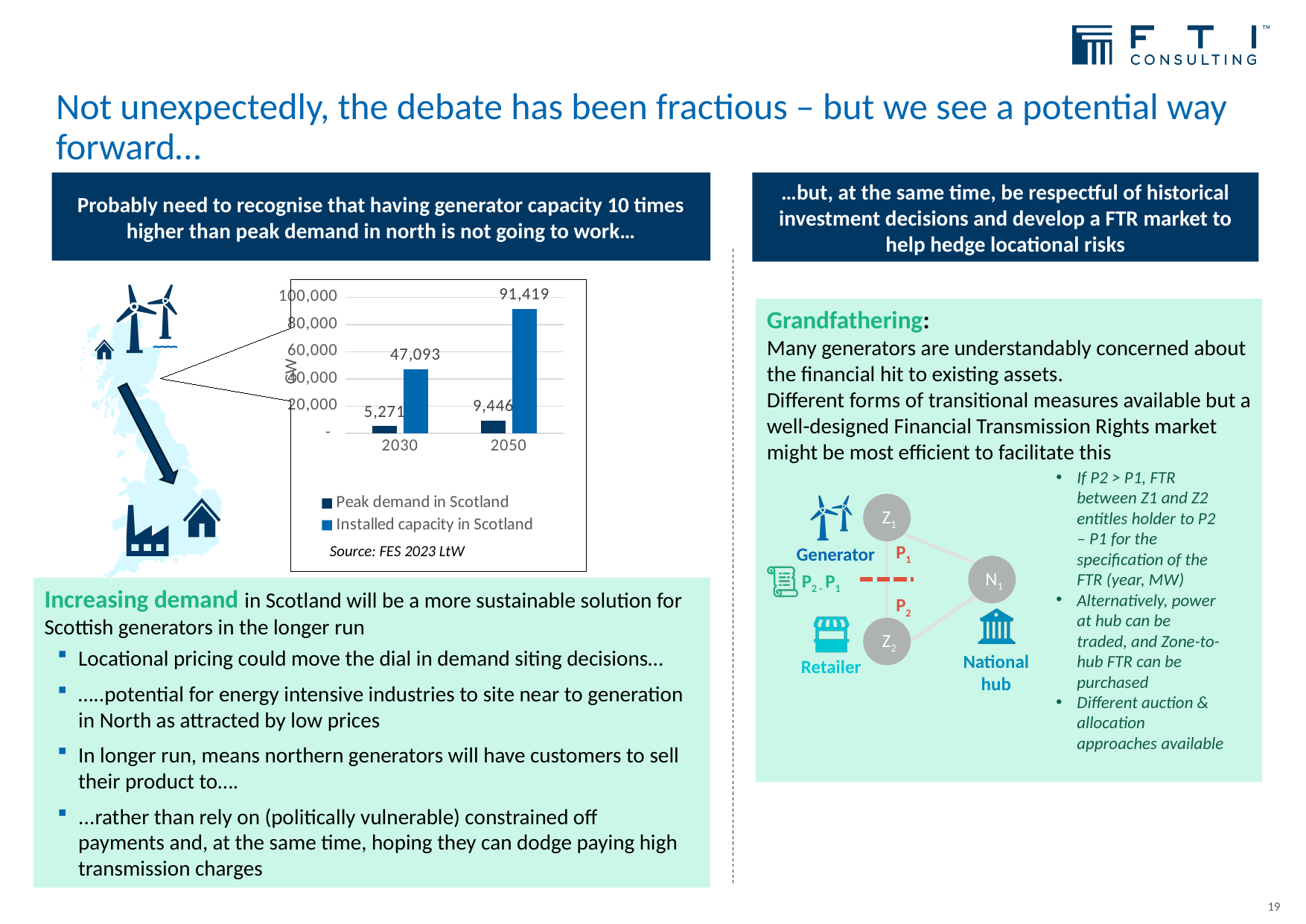
What type of chart is used to show peak demand and installed capacity in Scotland? Bar chart What is the peak demand in Scotland shown for 2030? 5,271 What is the difference between installed capacity and peak demand in Scotland in 2050? 81,973 How many year categories are shown on the x axis of the chart? 2 By how much does installed capacity in Scotland increase from 2030 to 2050? 44,326 What source is cited beneath the chart? FES 2023 LtW What is the installed capacity in Scotland shown for 2030? 47,093 What is the difference between installed capacity and peak demand in Scotland in 2030? 41,822 What is the peak demand in Scotland shown for 2050? 9,446 How many series does the chart legend list? 2 Which year has the higher installed capacity in Scotland, 2030 or 2050? 2050 What is the installed capacity in Scotland shown for 2050? 91,419